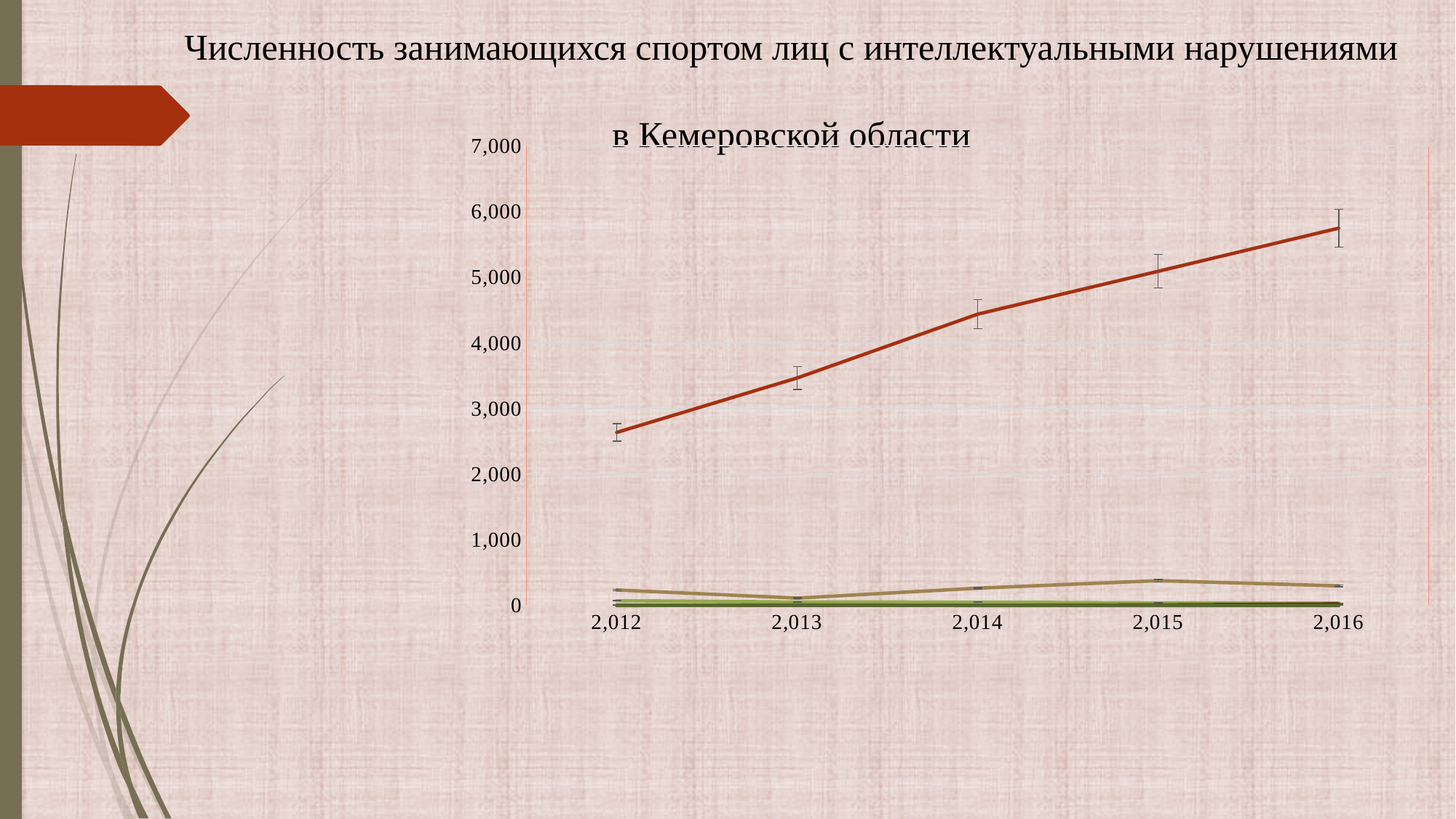
Which is larger for the red line: the value in 2,014 or the value in 2,016? 2,016 Is the value of the red line in 2,016 greater or less than 6,000? less In which year does the red (top) line reach its highest value? 2,016 What kind of chart is shown on the slide? line chart How many years are shown along the x axis of the chart? 5 Is the value of the red line in 2,014 greater or less than 4,000? greater In which year does the red (top) line have its lowest value? 2,012 Does the red (top) line rise or fall from 2,012 to 2,016? rises What is the highest value shown on the y axis of the chart? 7,000 Is the value of the red line in 2,012 greater or less than 3,000? less